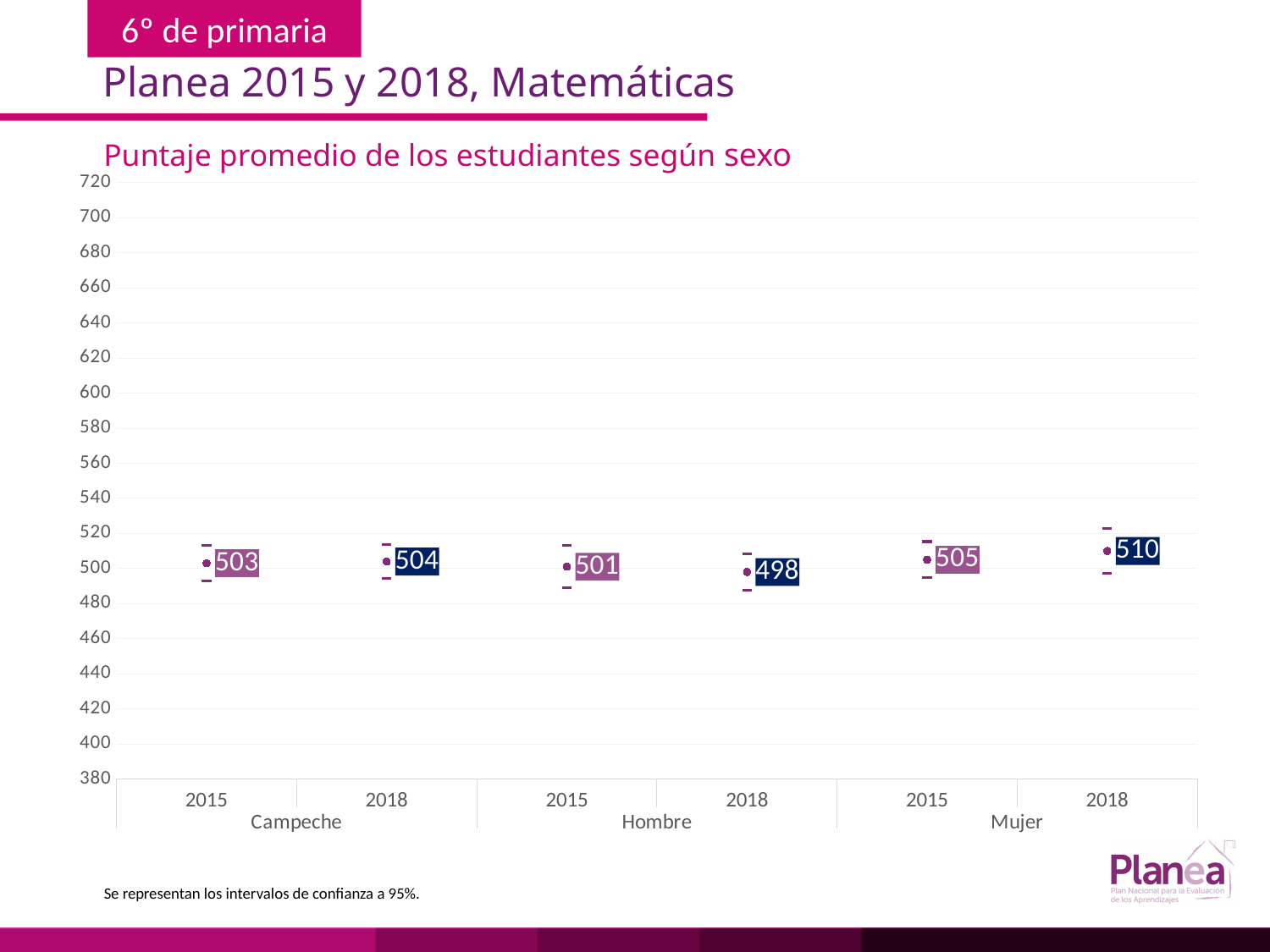
Which group and year has the lowest average score? Hombre 2018 What is the average score for Hombre in 2018? 498 What is the average score for Mujer in 2018? 510 What is the average score for Campeche in 2015? 503 What is the average score for Mujer in 2015? 505 What is the difference between the Mujer 2018 score and the Hombre 2018 score? 12 Did the Hombre average score rise or fall from 2015 to 2018? fall Which group and year has the highest average score? Mujer 2018 How many data points are plotted on the chart? 6 By how much did the Campeche average score change from 2015 to 2018? 1 What is the title of the chart? Puntaje promedio de los estudiantes según sexo Which is larger, the Hombre 2015 score or the Mujer 2015 score? Mujer 2015